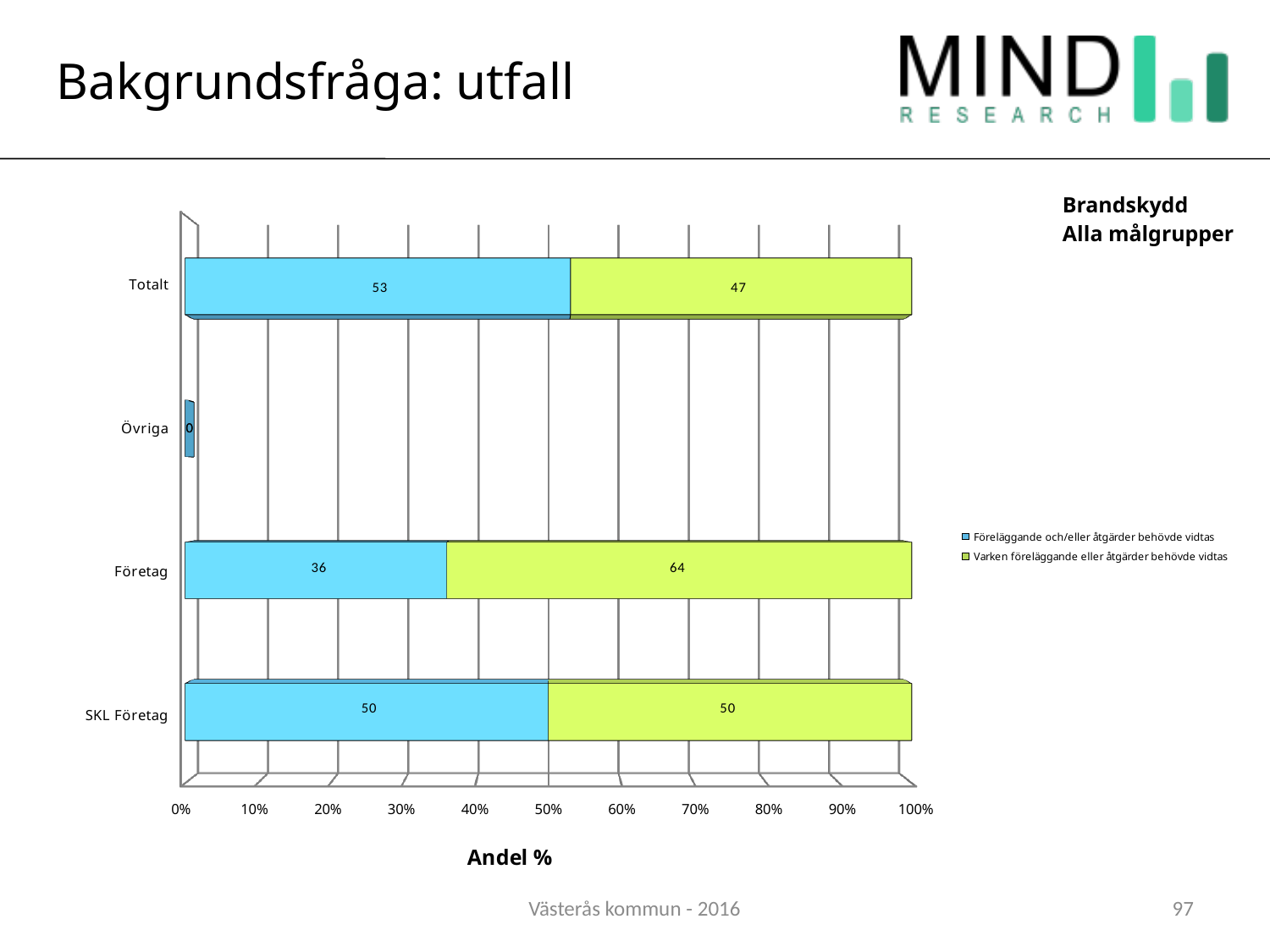
What is the value for "Varken föreläggande eller åtgärder behövde vidtas" for Totalt? 47 What is the label of the x axis of the chart? Andel % What is the value for "Varken föreläggande eller åtgärder behövde vidtas" for Företag? 64 Which is larger for Totalt: "Föreläggande och/eller åtgärder behövde vidtas" or "Varken föreläggande eller åtgärder behövde vidtas"? Föreläggande och/eller åtgärder behövde vidtas How many series does the legend list? 2 Which category has the lowest value for "Föreläggande och/eller åtgärder behövde vidtas"? Övriga What kind of chart is shown on the slide? Stacked bar chart Which category has the highest value for "Varken föreläggande eller åtgärder behövde vidtas"? Företag How many categories are shown on the y axis of the chart? 4 What is the value for "Föreläggande och/eller åtgärder behövde vidtas" for Totalt? 53 What is the difference between the two series values for Företag? 28 What is the value for "Föreläggande och/eller åtgärder behövde vidtas" for SKL Företag? 50